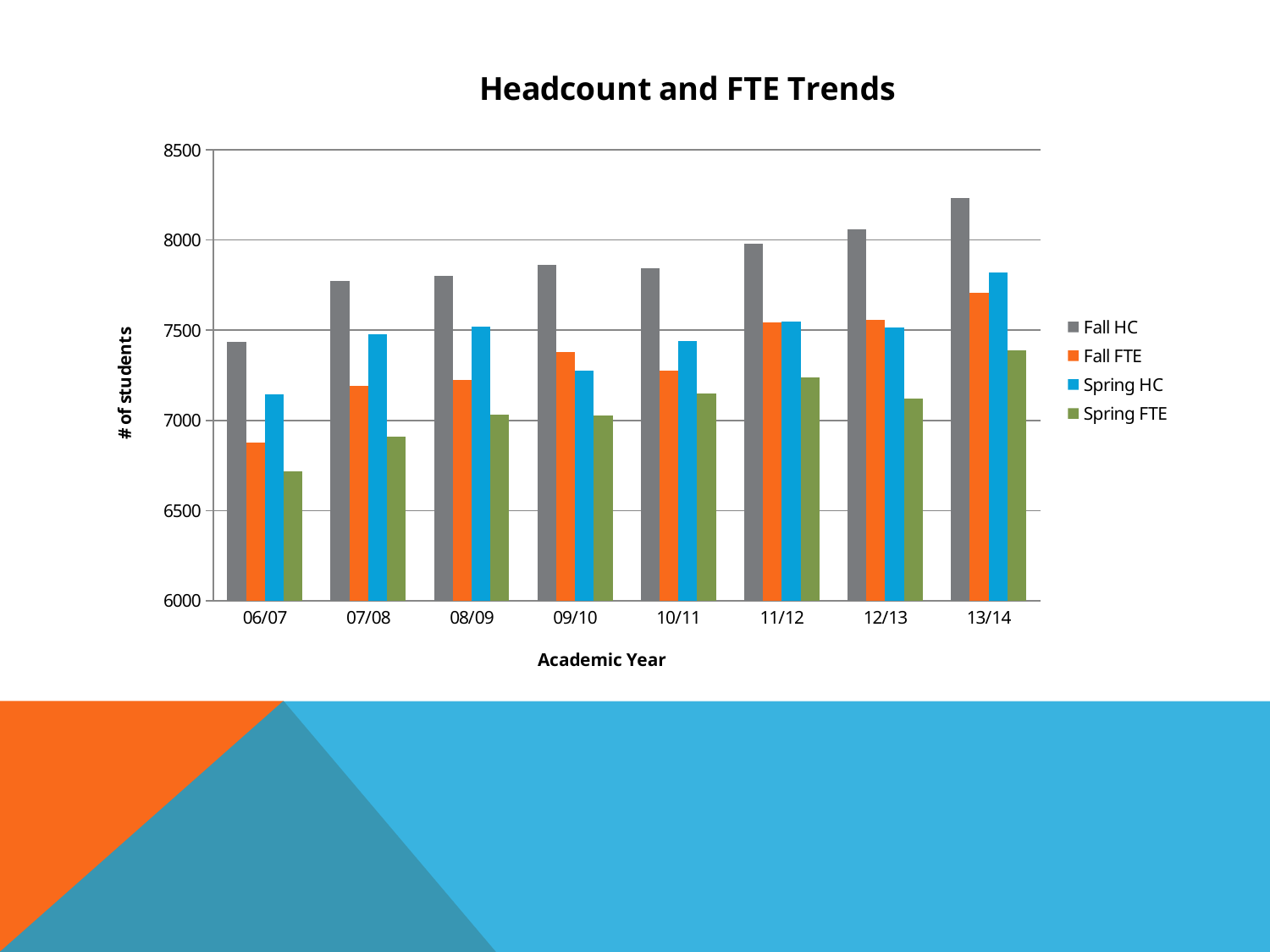
In which academic year is Spring HC highest? 13/14 In which academic year is Spring FTE lowest? 06/07 In which academic year is Fall HC highest? 13/14 Is the value for Spring HC in 13/14 greater or less than 7500? greater How many series does the legend list? 4 Does Fall HC generally rise or fall from 06/07 to 13/14? rise Is the value for Fall FTE in 06/07 greater or less than 7000? less How many academic years are shown on the x axis? 8 Is the value for Fall HC in 13/14 greater or less than 8000? greater What kind of chart is shown on the slide? bar chart In 06/07, which is larger: Spring HC or Fall FTE? Spring HC In which academic year is Fall HC lowest? 06/07